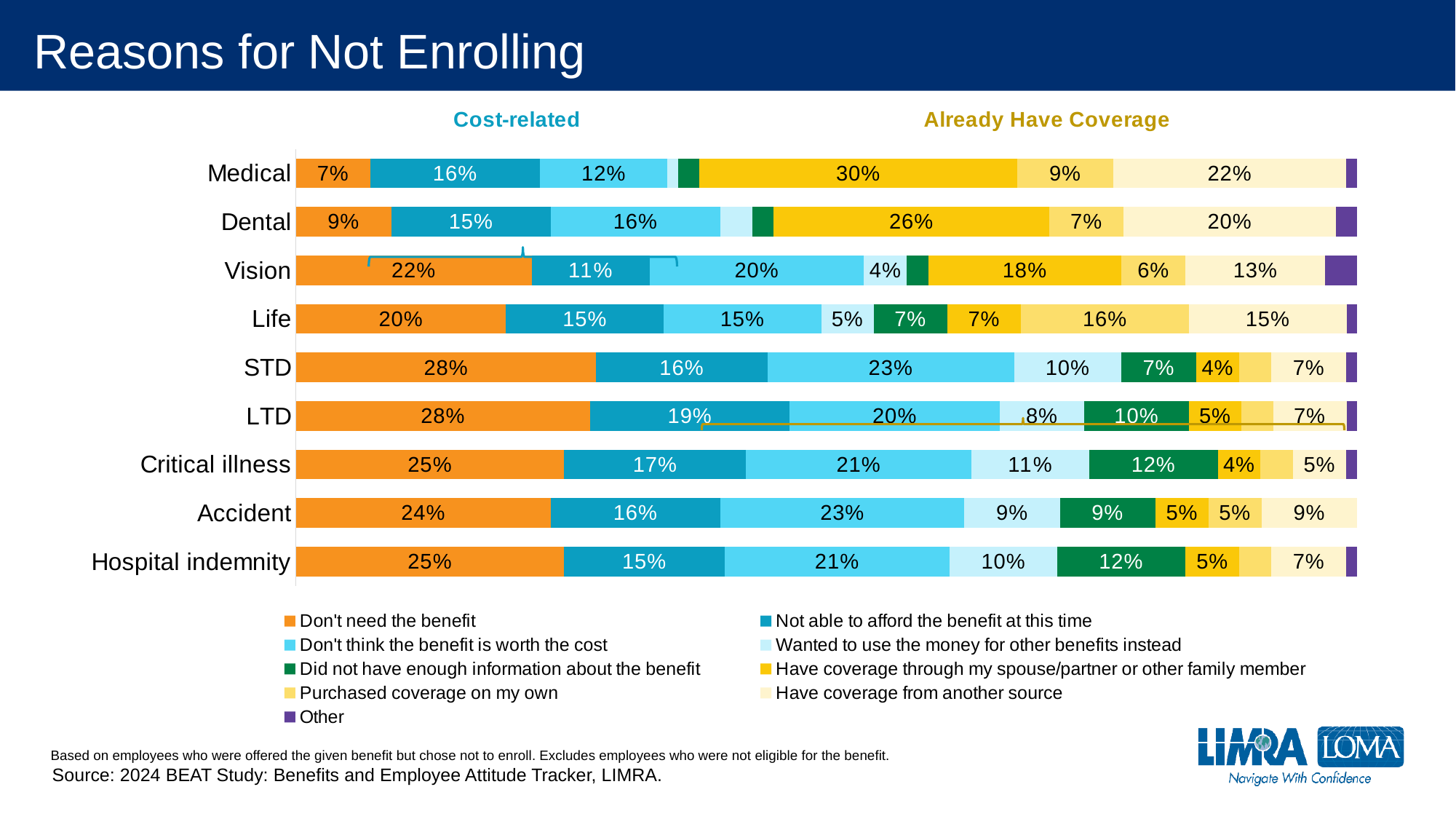
How many series does the legend list? 9 What is the 'Not able to afford the benefit at this time' value for LTD? 19% What kind of chart is shown on the slide? Stacked bar chart Which has a larger 'Don't need the benefit' share, Vision or Life? Vision How many benefit types are shown on the chart? 9 How much larger is the 'Have coverage through my spouse/partner or other family member' share for Medical than for Dental? 4% Which benefit has the highest share for 'Have coverage through my spouse/partner or other family member'? Medical For Hospital indemnity, what percentage did not have enough information about the benefit? 12% Which benefit has the lowest share for 'Don't need the benefit'? Medical What percentage of employees who did not enroll in Medical coverage said they have coverage through a spouse/partner or other family member? 30% What is the value for 'Don't need the benefit' for Vision? 22% What share of STD non-enrollees said they don't think the benefit is worth the cost? 23%